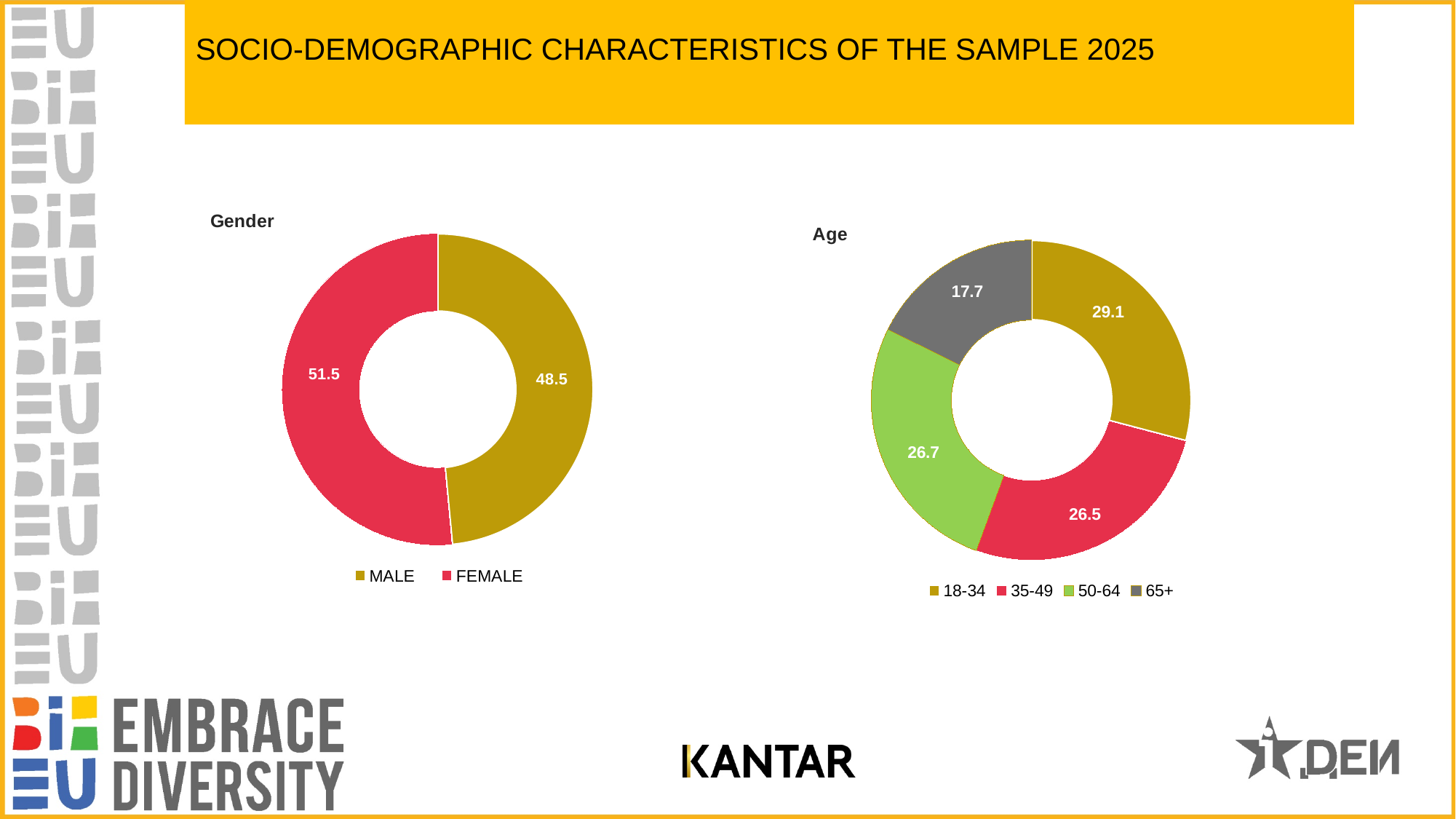
In the Age chart, what is the value for the 18-34 group? 29.1 In the Age chart, which age group has the largest value? 18-34 In the Gender chart, what is the value for FEMALE? 51.5 What type of chart is the Gender chart? Pie chart (doughnut) In the Age chart, what is the value for the 65+ group? 17.7 In the Gender chart, which category has the larger value? FEMALE In the Gender chart, what is the difference between the FEMALE and MALE values? 3.0 In the Age chart, what is the difference between the 18-34 and 65+ values? 11.4 In the Age chart, which colour represents the 50-64 group? Green In the Gender chart, what is the value for MALE? 48.5 In the Age chart, which age group has the smallest value? 65+ In the Age chart, how many age groups are shown? 4